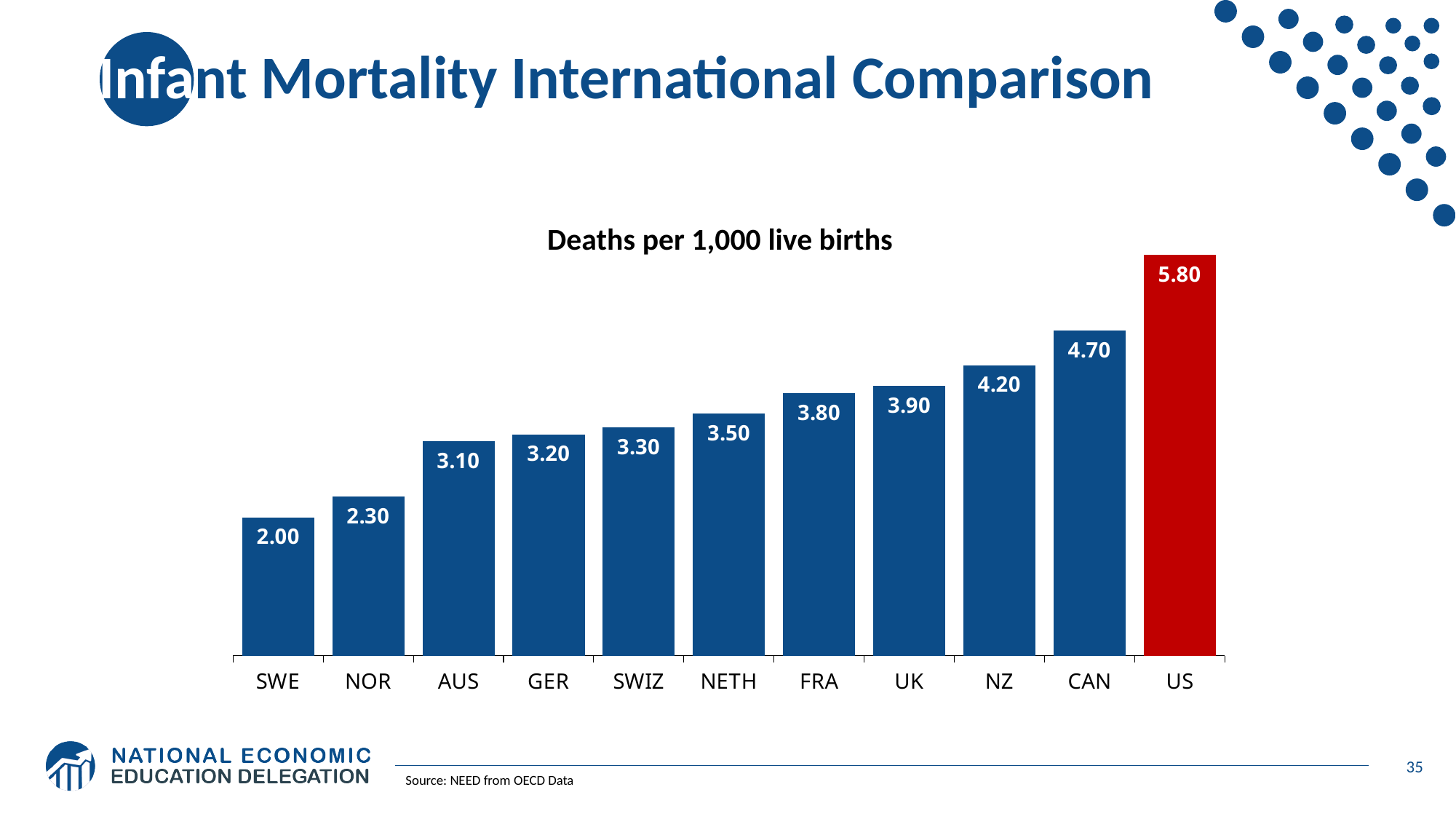
Which is larger, the value for UK or the value for GER? UK Do the values rise or fall from left to right along the x axis? Rise How many countries are shown on the chart? 11 What is the title of the chart? Deaths per 1,000 live births What is the value for SWE? 2.00 What is the difference between the values for NOR and SWE? 0.30 What is the difference between the values for the US and CAN? 1.10 What is the value for the US? 5.80 What is the value for FRA? 3.80 Which country has the lowest value? SWE What kind of chart is this? Bar chart Which country has the highest value? US